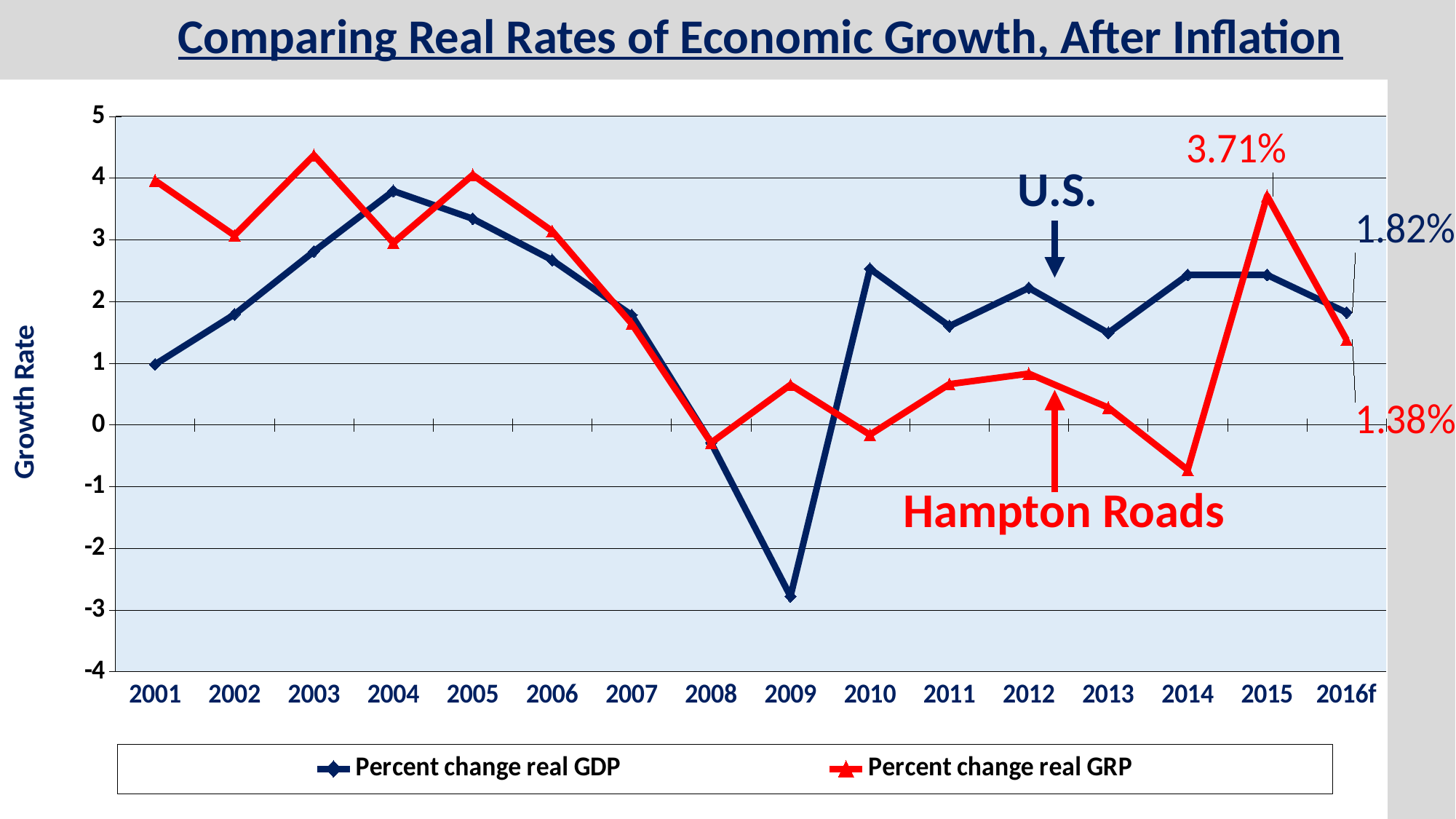
In which year is the Percent change real GDP line at its highest? 2004 In which year is the Percent change real GDP line at its lowest? 2009 How many years are shown on the x axis? 16 What is the difference between the U.S. value (1.82%) and the Hampton Roads value (1.38%) in 2016f? 0.44 percentage points In 2016f, which series has the larger value: Percent change real GDP or Percent change real GRP? Percent change real GDP What is the labelled value for Percent change real GRP (Hampton Roads) in 2016f? 1.38% What is the labelled value for Percent change real GDP (U.S.) in 2016f? 1.82% Is the Percent change real GRP value for 2003 greater or less than 4? greater How many series does the legend list? 2 What is the labelled value for Percent change real GRP (Hampton Roads) in 2015? 3.71% Is the Percent change real GDP value for 2009 greater or less than -2? less What kind of chart is shown on the slide? Line chart